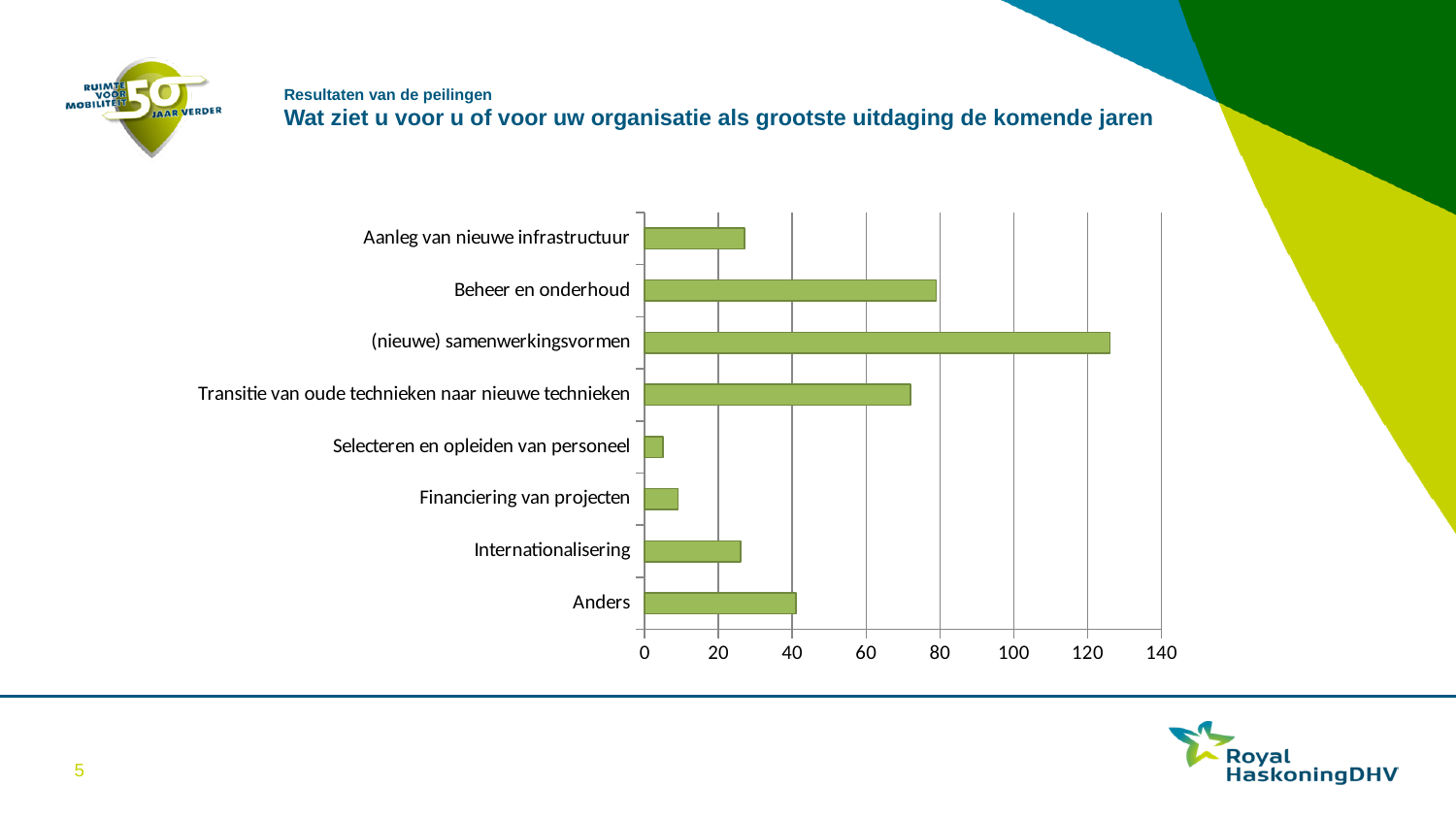
Is the value for Transitie van oude technieken naar nieuwe technieken greater or less than 80? less What is the highest value shown on the horizontal axis of the chart? 140 Is the value for Financiering van projecten greater or less than 20? less Is the value for (nieuwe) samenwerkingsvormen greater or less than 100? greater Which category has the lowest value? Selecteren en opleiden van personeel How many categories are shown in the chart? 8 What kind of chart is shown on the slide? bar chart Which is larger, the value for Anders or the value for Aanleg van nieuwe infrastructuur? Anders Which is larger, the value for Beheer en onderhoud or the value for Internationalisering? Beheer en onderhoud Which category has the highest value? (nieuwe) samenwerkingsvormen